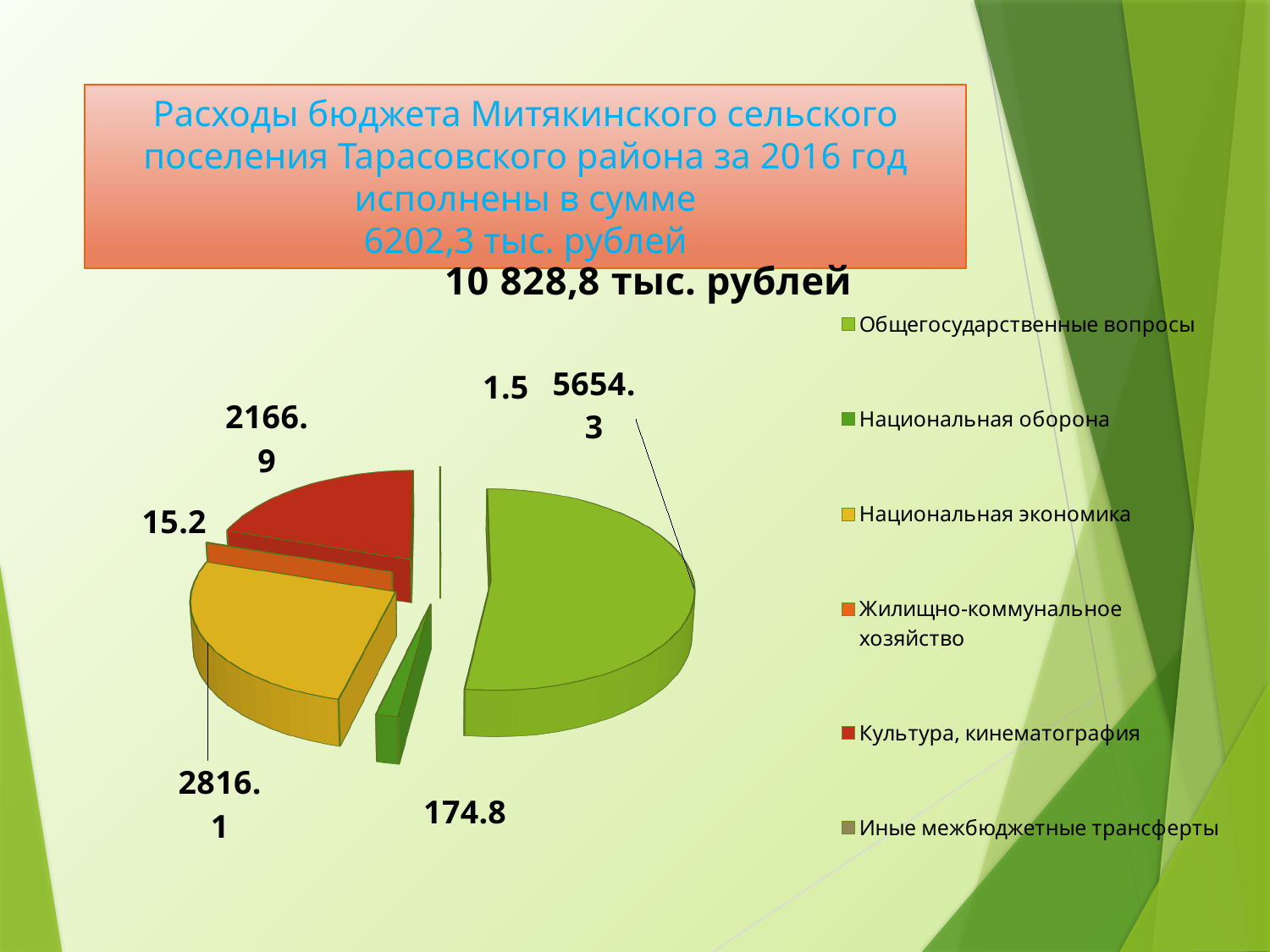
Which category has the largest slice in the pie chart? Общегосударственные вопросы What is the value for Культура, кинематография in the pie chart? 2166.9 What is the difference between the values for Общегосударственные вопросы and Национальная экономика? 2838.2 What is the value for Жилищно-коммунальное хозяйство in the pie chart? 15.2 What is the value for Национальная экономика in the pie chart? 2816.1 What total amount is shown in the chart title above the pie? 10 828,8 тыс. рублей What type of chart is shown on the slide? Pie chart Which is larger: the value for Национальная экономика or the value for Культура, кинематография? Национальная экономика How many categories does the legend of the pie chart list? 6 Which category has the smallest slice in the pie chart? Иные межбюджетные трансферты What is the value for Национальная оборона in the pie chart? 174.8 What is the value for Общегосударственные вопросы in the pie chart? 5654.3